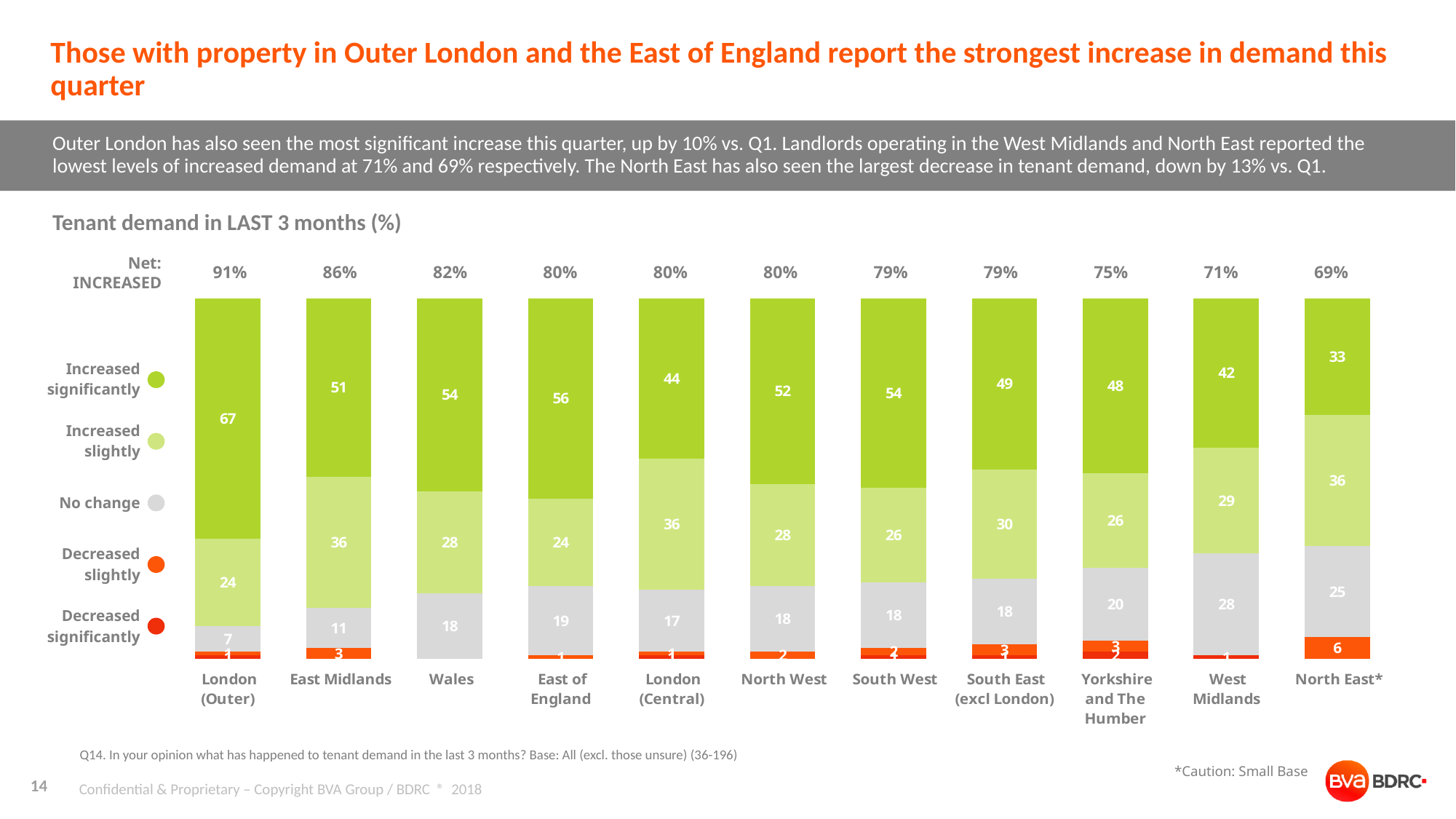
Which has the larger 'Increased slightly' value, North East* or Wales? North East* What is the Net: INCREASED percentage for Yorkshire and The Humber? 75% What is the 'No change' value for West Midlands? 28 How many regions are shown along the x axis of the chart? 11 What is the difference between the 'Increased significantly' values for London (Outer) and North East*? 34 Which region has the highest 'No change' value? West Midlands Which region has the lowest Net: INCREASED percentage? North East* Which region has the highest Net: INCREASED percentage? London (Outer) What is the title of the chart? Tenant demand in LAST 3 months (%) What kind of chart is shown on the slide? Stacked bar chart What is the 'Increased significantly' value for London (Outer)? 67 How many series does the chart's legend list? 5